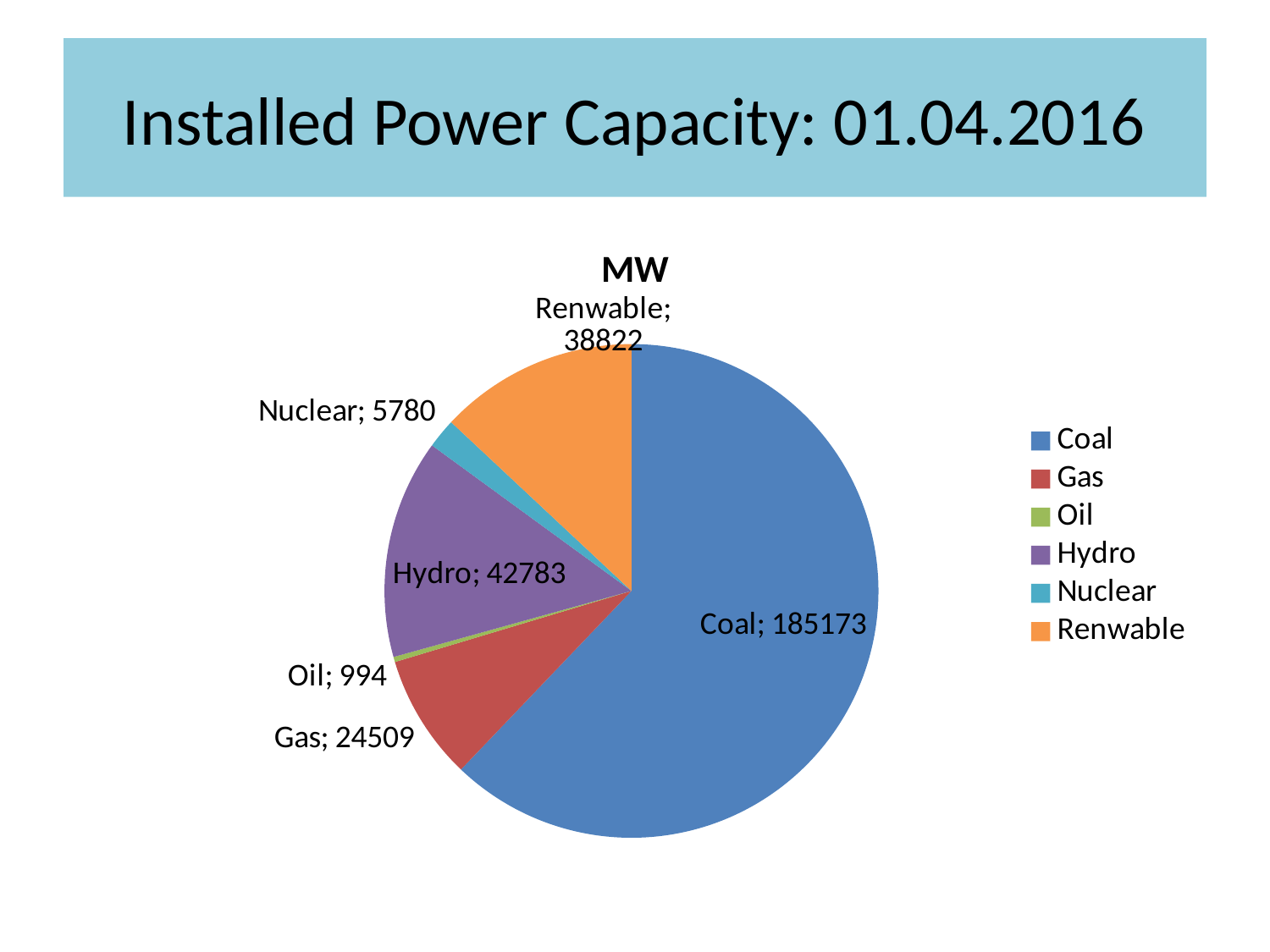
What is the value for Hydro in the pie chart? 42783 Which category has the largest slice of the pie chart? Coal What is the value for Coal in the pie chart? 185173 Which category has the smallest slice of the pie chart? Oil What is the value for Oil in the pie chart? 994 Which is larger, the value for Gas or the value for Nuclear? Gas What is the difference between the Hydro and Renwable values? 3961 What is the value for Nuclear in the pie chart? 5780 How many categories does the pie chart show? 6 What type of chart is shown on the slide? pie chart What is the difference between the Coal and Gas values? 160664 What is the title of the pie chart? MW